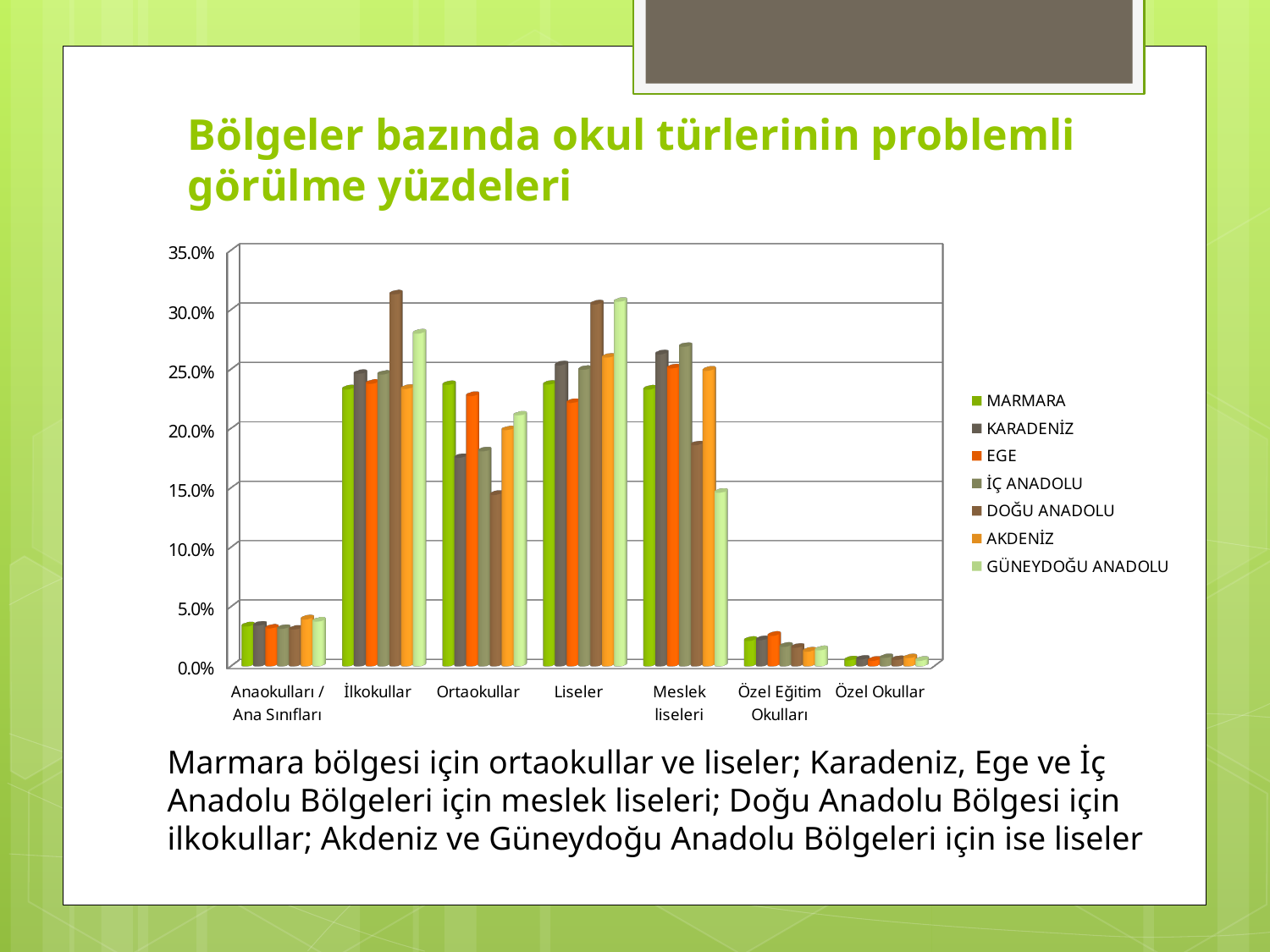
What is the title of the slide containing the chart? Bölgeler bazında okul türlerinin problemli görülme yüzdeleri In the Meslek liseleri category, which is larger: the value for KARADENİZ or the value for GÜNEYDOĞU ANADOLU? KARADENİZ Which region has the highest value in the İlkokullar category? DOĞU ANADOLU Which region has the lowest value in the Meslek liseleri category? GÜNEYDOĞU ANADOLU How many series does the legend list? 7 How many school-type categories are shown on the x axis? 7 What kind of chart is shown on the slide? bar chart Is the value for DOĞU ANADOLU in the İlkokullar category greater or less than 30.0%? greater Is the value for AKDENİZ in the Anaokulları / Ana Sınıfları category greater or less than 5.0%? less Is the value for GÜNEYDOĞU ANADOLU in the Meslek liseleri category greater or less than 20.0%? less In the Ortaokullar category, which is larger: the value for MARMARA or the value for DOĞU ANADOLU? MARMARA